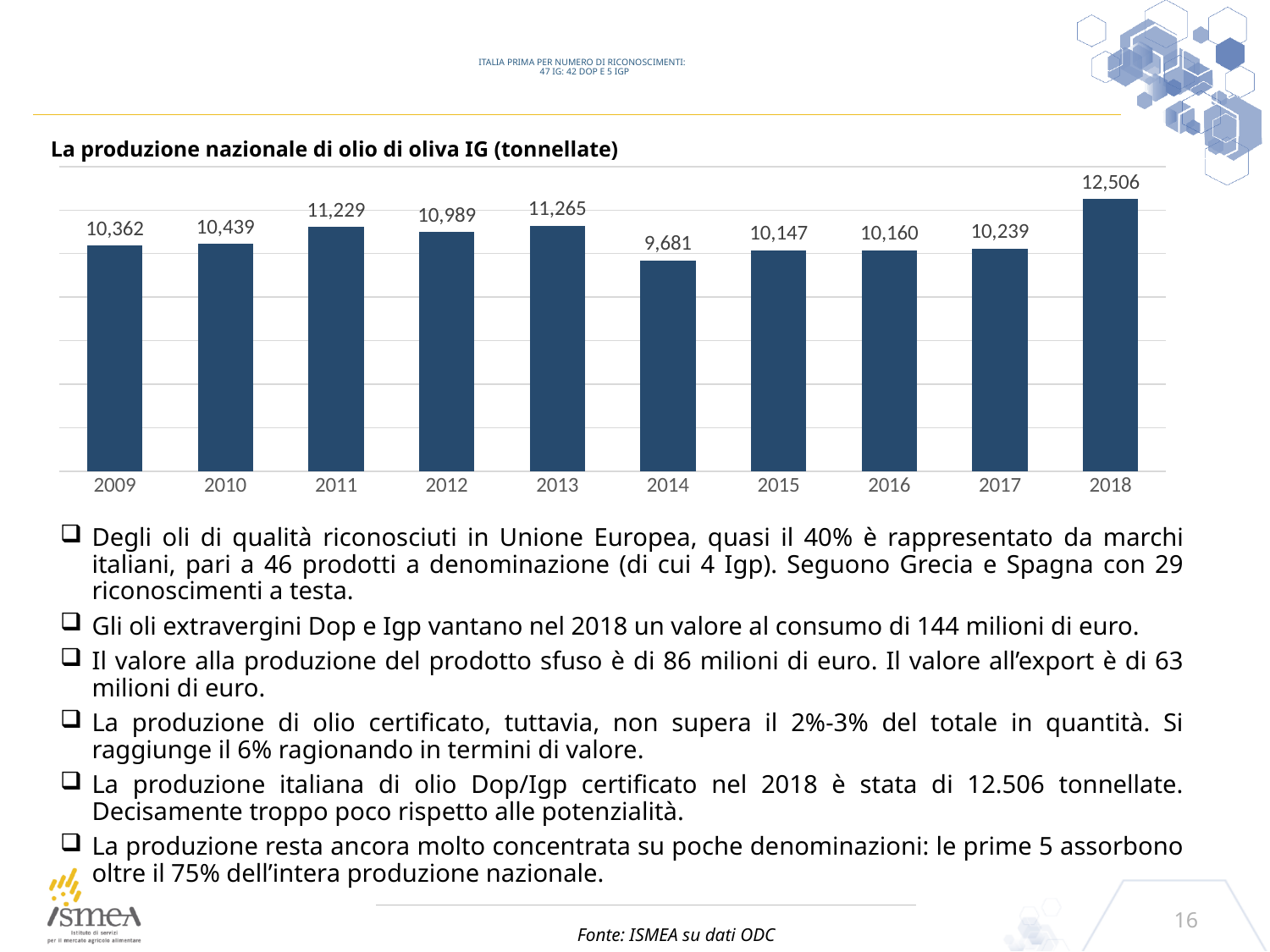
What is the title of the chart? La produzione nazionale di olio di oliva IG (tonnellate) What is the value for 2011? 11,229 What is the value for 2014? 9,681 Which year has the lowest value? 2014 What is the value for 2018? 12,506 What is the difference between the values for 2018 and 2017? 2,267 Which is larger, the value for 2011 or the value for 2012? 2011 How many years are shown on the x axis? 10 Which year has the highest value? 2018 What kind of chart is this? Bar chart What is the difference between the values for 2013 and 2014? 1,584 Do the values rise or fall from 2014 to 2018? Rise